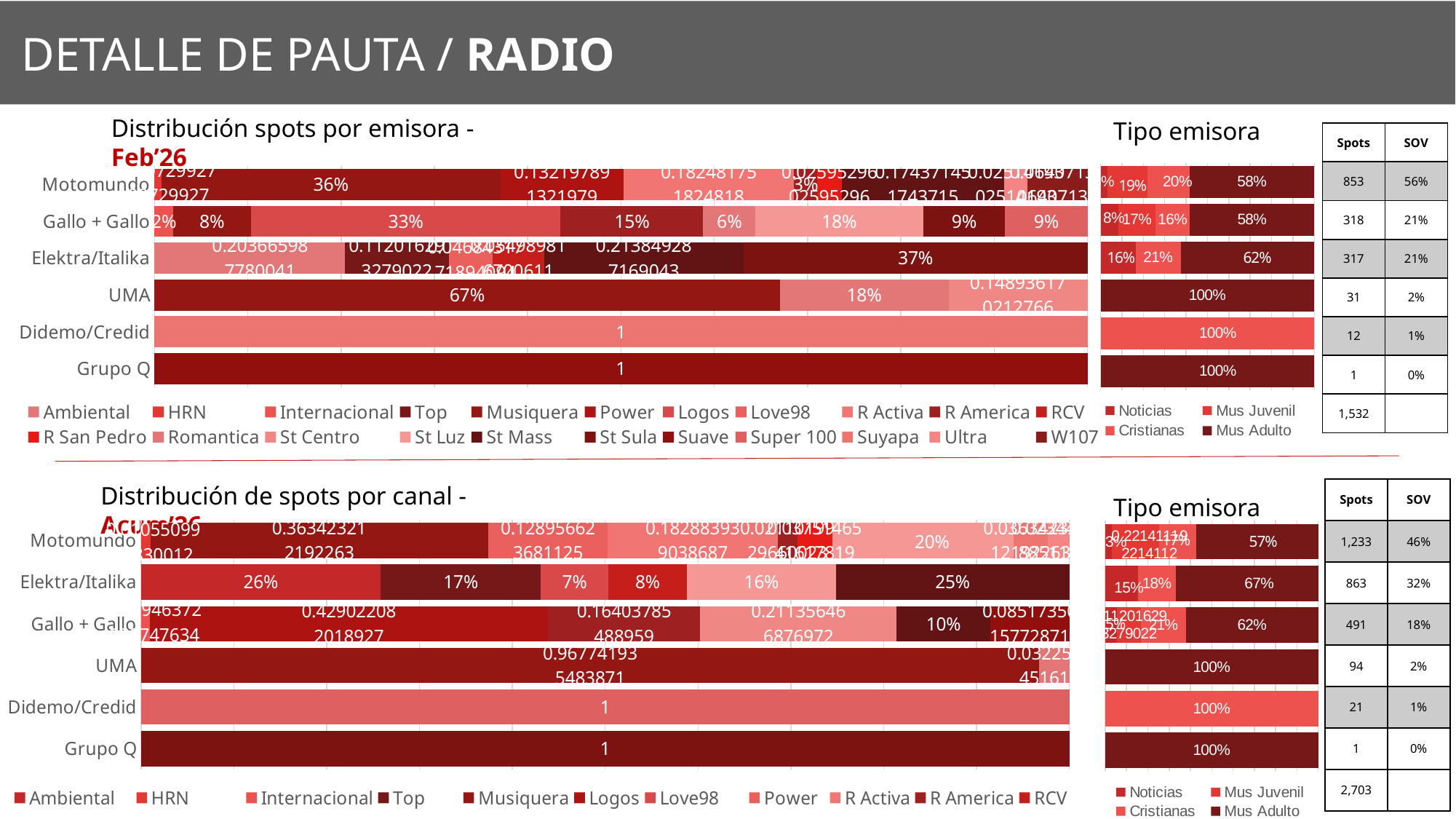
In the bottom-left chart 'Distribución de spots por canal - Acum'26', what is the largest labelled segment for Elektra/Italika? 26% What kind of chart is the top-left 'Distribución spots por emisora - Feb'26'? Stacked bar chart In the top-right 'Tipo emisora' chart, what is the value shown for UMA? 100% In the top-left chart 'Distribución spots por emisora - Feb'26', what is the largest labelled segment for Gallo + Gallo? 33% In the bottom-right 'Tipo emisora' chart, what is the Mus Adulto share for Elektra/Italika? 67% In the top-right 'Tipo emisora' chart, what is the Mus Adulto share for Motomundo? 58% In the top-left chart 'Distribución spots por emisora - Feb'26', what is the largest labelled segment for UMA? 67% How many series does the legend of the top-right 'Tipo emisora' chart list? 4 How many categories (rows) does the top-left chart 'Distribución spots por emisora - Feb'26' show? 6 In the bottom-left chart 'Distribución de spots por canal - Acum'26', what is the difference between the 26% and 17% segments for Elektra/Italika? 9% In the top-left chart 'Distribución spots por emisora - Feb'26', what is the largest labelled segment for Elektra/Italika? 37%